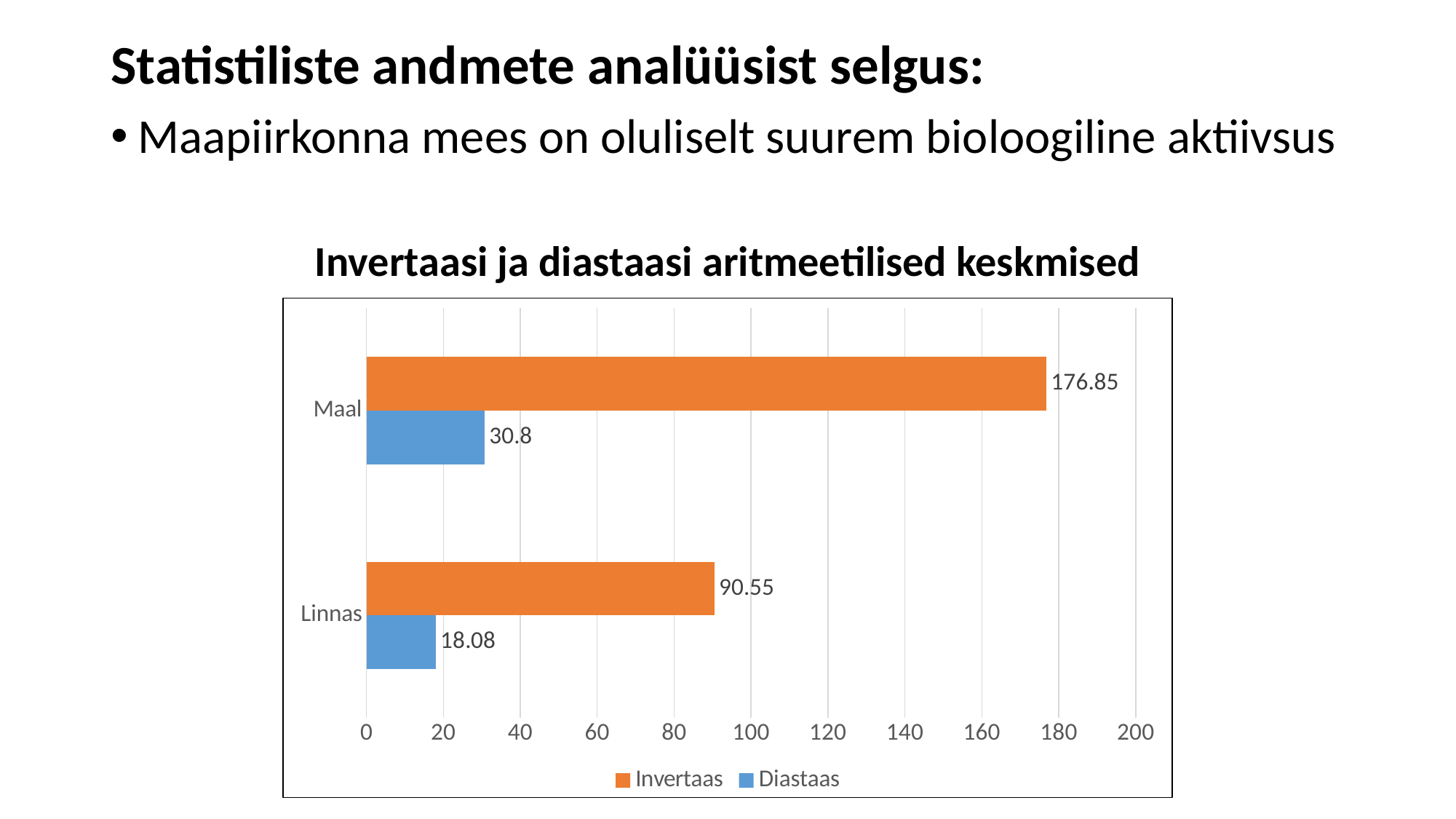
What is the Invertaas value for Maal? 176.85 What is the Diastaas value for Maal? 30.8 What is the Invertaas value for Linnas? 90.55 How many categories are shown on the chart? 2 What is the Diastaas value for Linnas? 18.08 What is the difference between the Invertaas values for Maal and Linnas? 86.3 Which category has the highest Invertaas value? Maal What kind of chart is shown on the slide? Bar chart How many series does the legend list? 2 Which is larger: the Diastaas value for Maal or the Diastaas value for Linnas? Maal Which category has the lowest Diastaas value? Linnas What is the title of the chart? Invertaasi ja diastaasi aritmeetilised keskmised